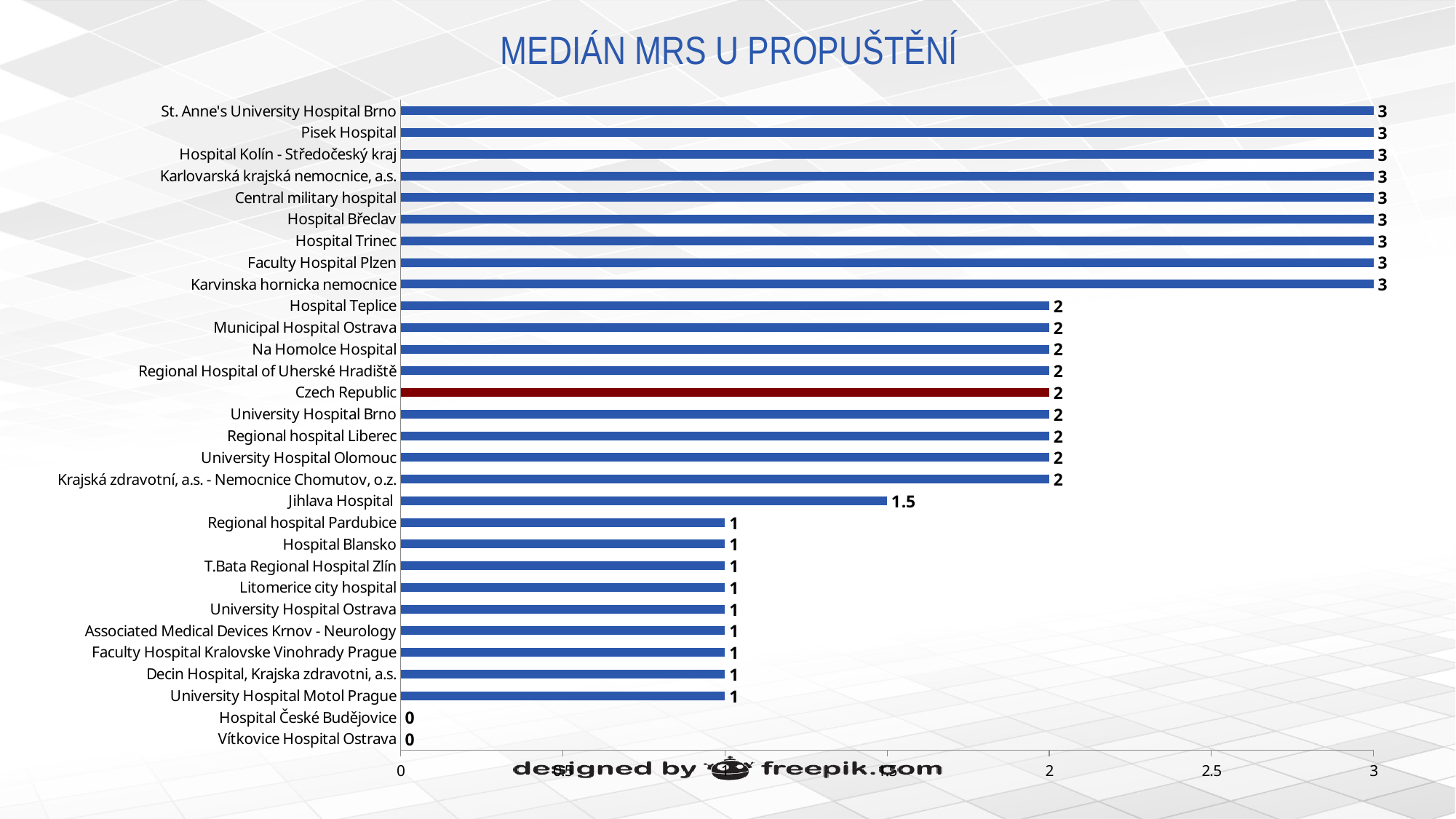
What is the value for Jihlava Hospital? 1.5 What is the value for University Hospital Motol Prague? 1 How many categories have a value of 0? 2 What is the value for Vítkovice Hospital Ostrava? 0 How many categories are shown on the chart? 30 What is the difference between the values for St. Anne's University Hospital Brno and Jihlava Hospital? 1.5 What is the value for Czech Republic? 2 What is the title of the chart? MEDIÁN MRS U PROPUŠTĚNÍ Is the value for Jihlava Hospital greater or less than 2? less What kind of chart is shown on the slide? bar chart Which is larger, the value for Hospital Teplice or the value for Hospital Blansko? Hospital Teplice What is the value for Hospital Trinec? 3